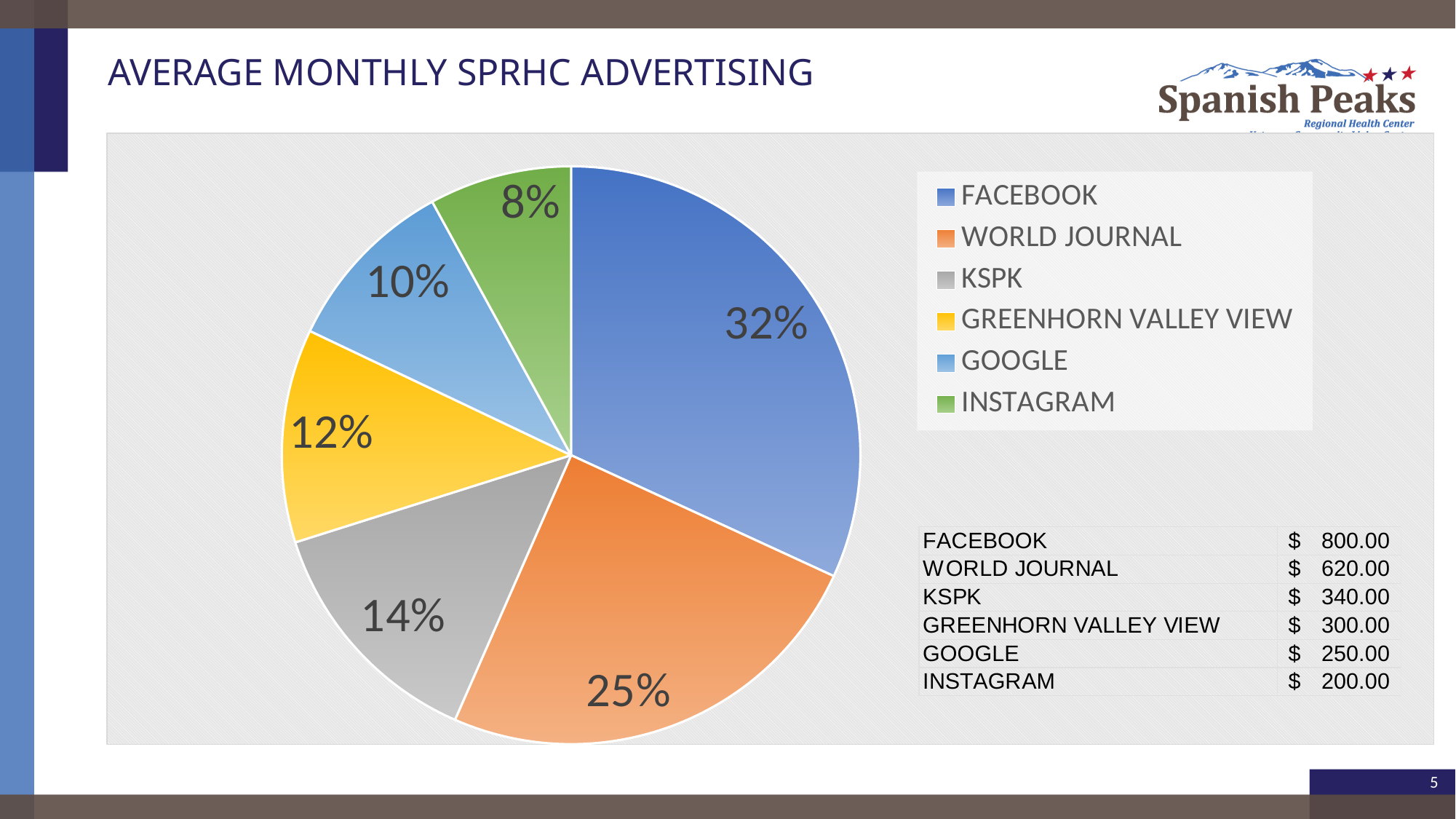
What kind of chart is shown on the slide? pie chart What share of the pie does INSTAGRAM have? 8% What share of the pie does FACEBOOK have? 32% What share of the pie does GREENHORN VALLEY VIEW have? 12% Which category has the largest slice of the pie? FACEBOOK Which category has the smallest slice of the pie? INSTAGRAM Which slice is larger, GOOGLE or GREENHORN VALLEY VIEW? GREENHORN VALLEY VIEW What colour is the KSPK slice in the pie chart? grey What is the difference in percentage points between the FACEBOOK slice and the WORLD JOURNAL slice? 7% How many slices does the pie chart have? 6